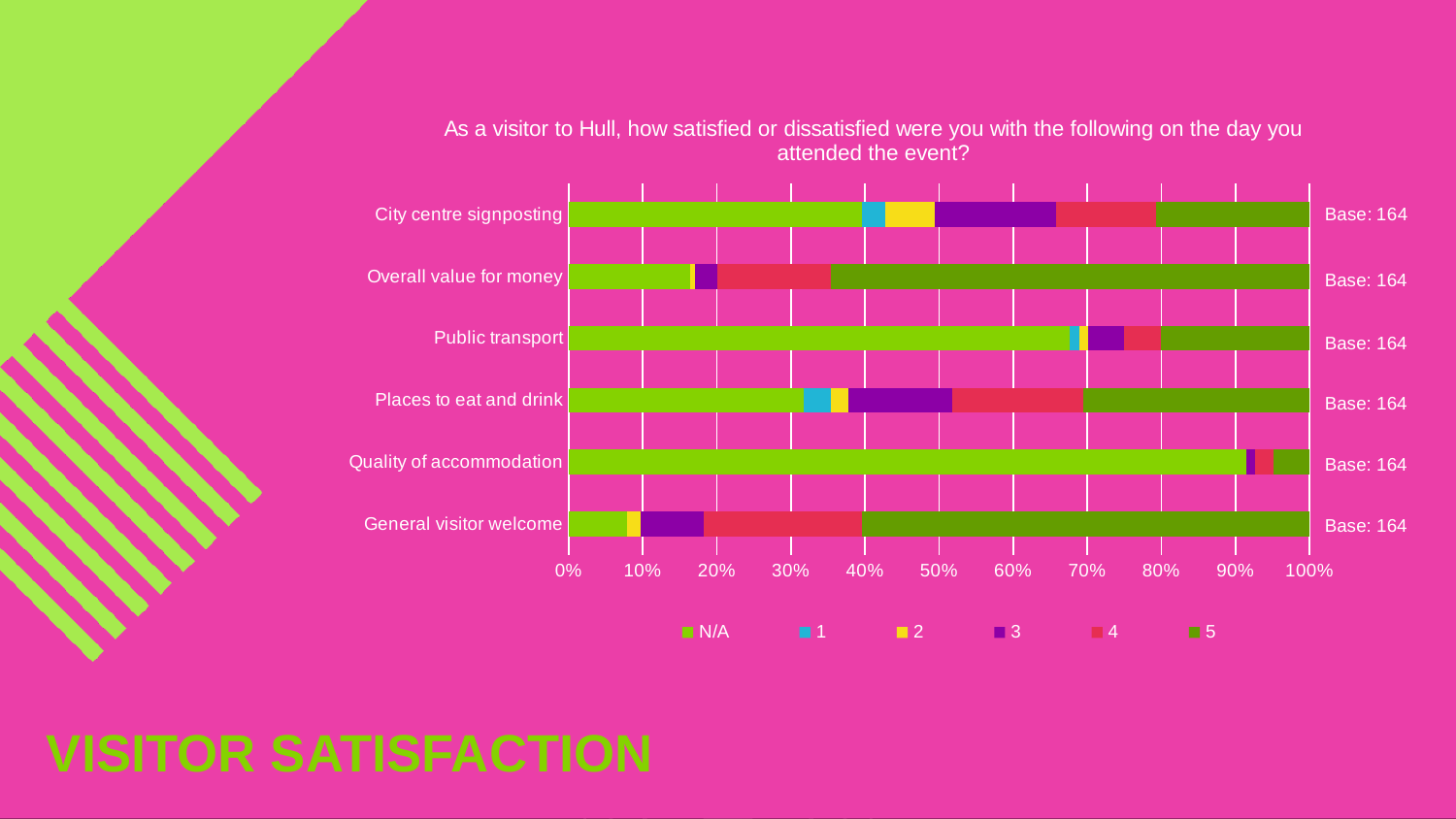
What is the first entry listed in the chart legend? N/A Which has the larger N/A share: Public transport or Overall value for money? Public transport What base (number of respondents) is shown next to each bar? Base: 164 Is the N/A share for Quality of accommodation greater or less than 80%? greater Which category has the smallest N/A share? General visitor welcome How many series does the chart legend list? 6 Which category has the largest N/A share? Quality of accommodation How many categories (aspects of the visit) are plotted on the chart? 6 Is the N/A share for General visitor welcome greater or less than 10%? less What kind of chart is shown on the slide? Stacked bar chart Is the N/A share for Public transport greater or less than 60%? greater